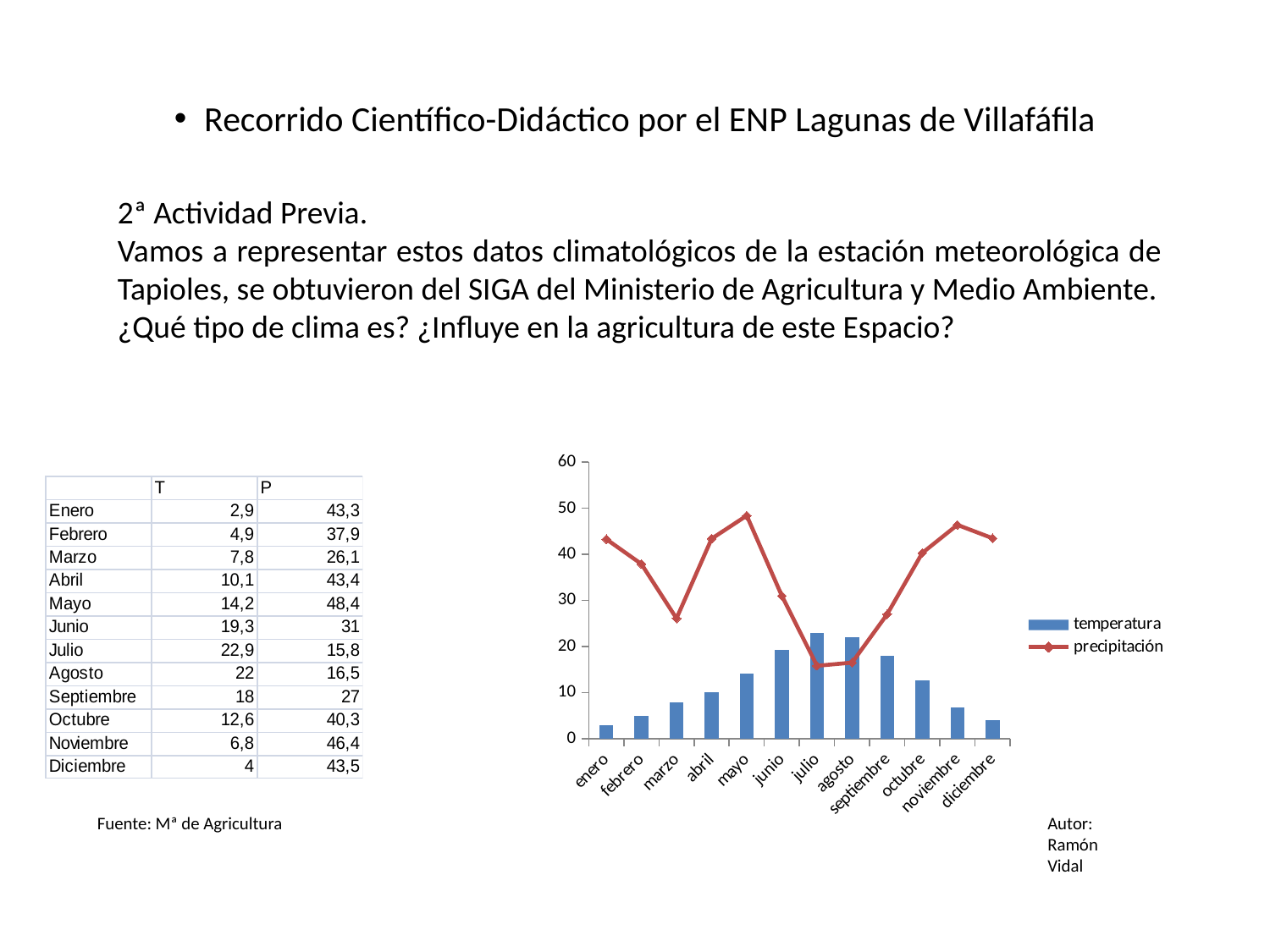
Do the temperatura bars rise or fall from enero to julio? rise What is the precipitación value for octubre? 40,3 Is the precipitación value for marzo greater or less than 30? less What kind of chart is shown on the slide? a combined bar and line chart Which month has the higher precipitación value, enero or febrero? enero Which month has the lowest temperatura bar in the chart? enero What is the difference between the precipitación values for mayo and julio? 32,6 How many series does the chart legend list? 2 How many months are plotted along the x axis of the chart? 12 Which month has the highest precipitación value in the chart? mayo What is the temperatura value for mayo? 14,2 Which month has the highest temperatura bar in the chart? julio